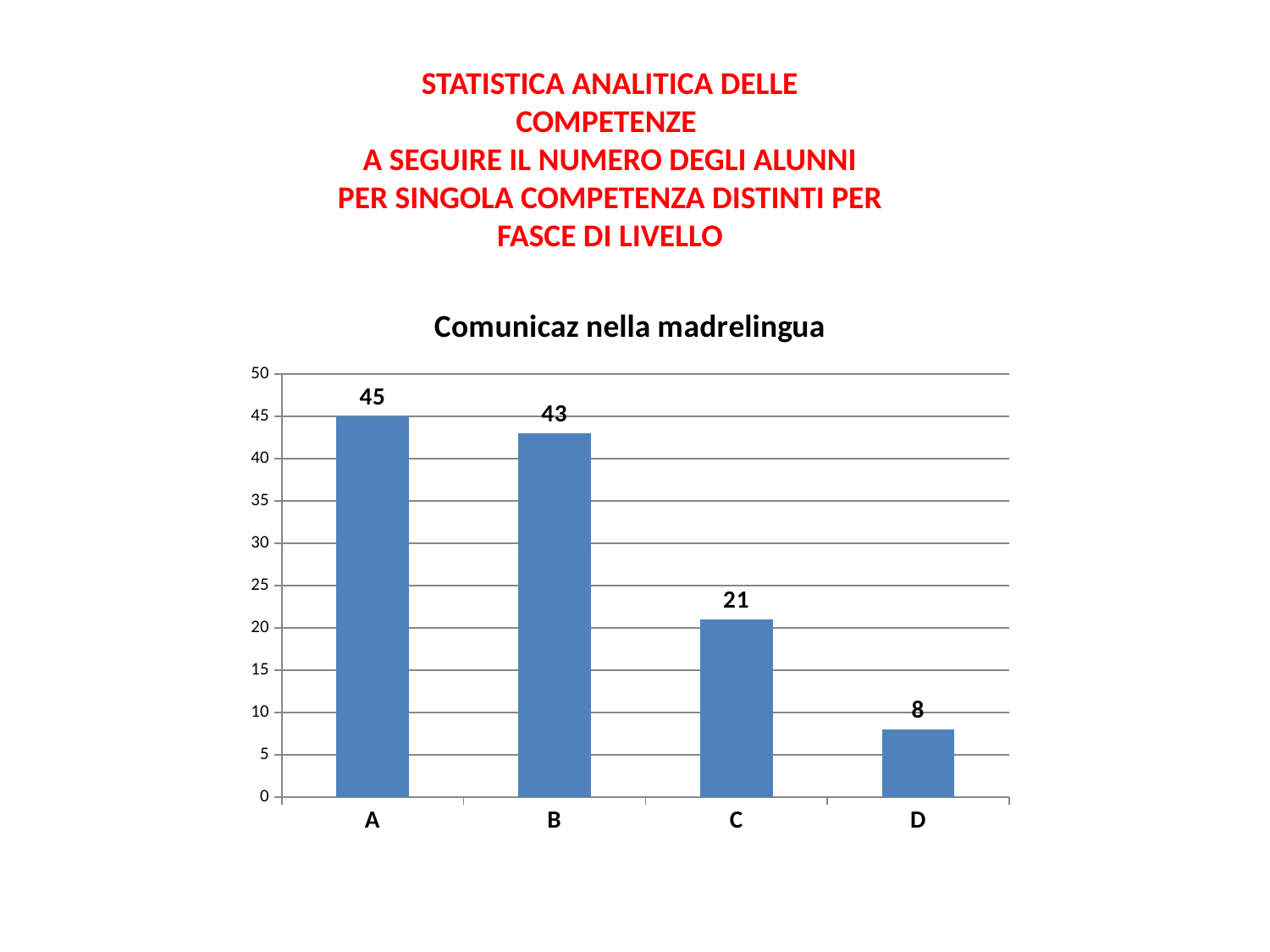
What is the difference between the values for B and D? 35 What is the value for category C? 21 Which category has the highest value? A What is the value for category B? 43 What is the value for category D? 8 What kind of chart is shown on the slide? Bar chart Which is larger, the value for C or the value for D? C How many categories are shown on the x axis? 4 What is the value for category A? 45 Which category has the lowest value? D What is the title of the chart? Comunicaz nella madrelingua What is the difference between the values for A and C? 24